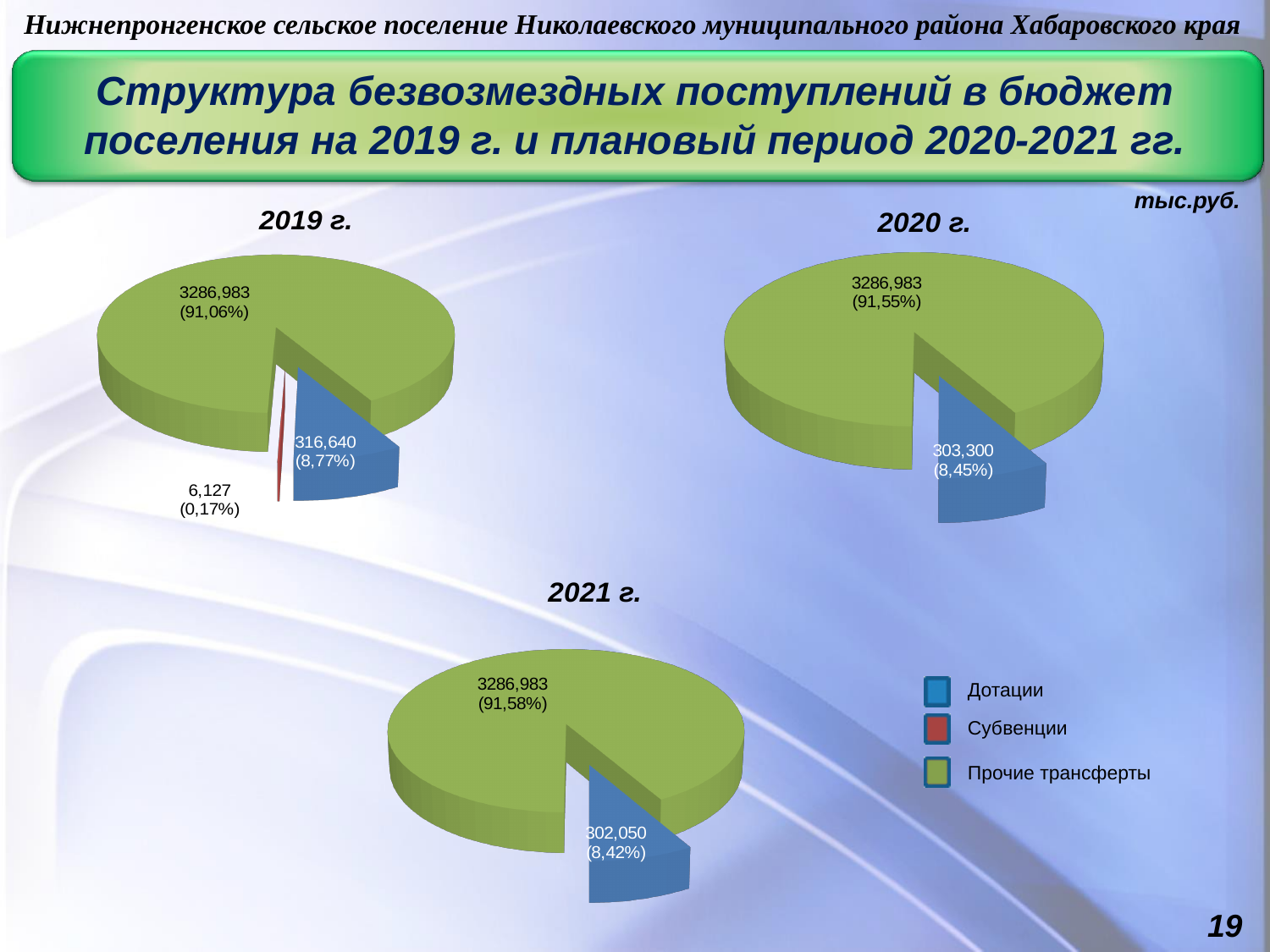
How many entries does the legend list? 3 In the 2021 г. pie chart, which category has the largest slice? Прочие трансферты In the 2020 г. pie chart, what share of the pie do Прочие трансферты make up? 91,55% In the 2019 г. pie chart, what is the value for Субвенции? 6,127 How many slices does the 2019 г. pie chart have? 3 In the 2021 г. pie chart, what is the value for Дотации? 302,050 What type of chart is used for 2020 г.? Pie chart In the 2020 г. pie chart, what is the value for Дотации? 303,300 In the 2019 г. pie chart, what share of the pie do Дотации make up? 8,77% In the 2019 г. pie chart, what is the value for Прочие трансферты? 3286,983 In the 2019 г. pie chart, which category has the smallest slice? Субвенции Which is larger: Дотации in the 2019 г. chart or Дотации in the 2021 г. chart? Дотации in 2019 г.